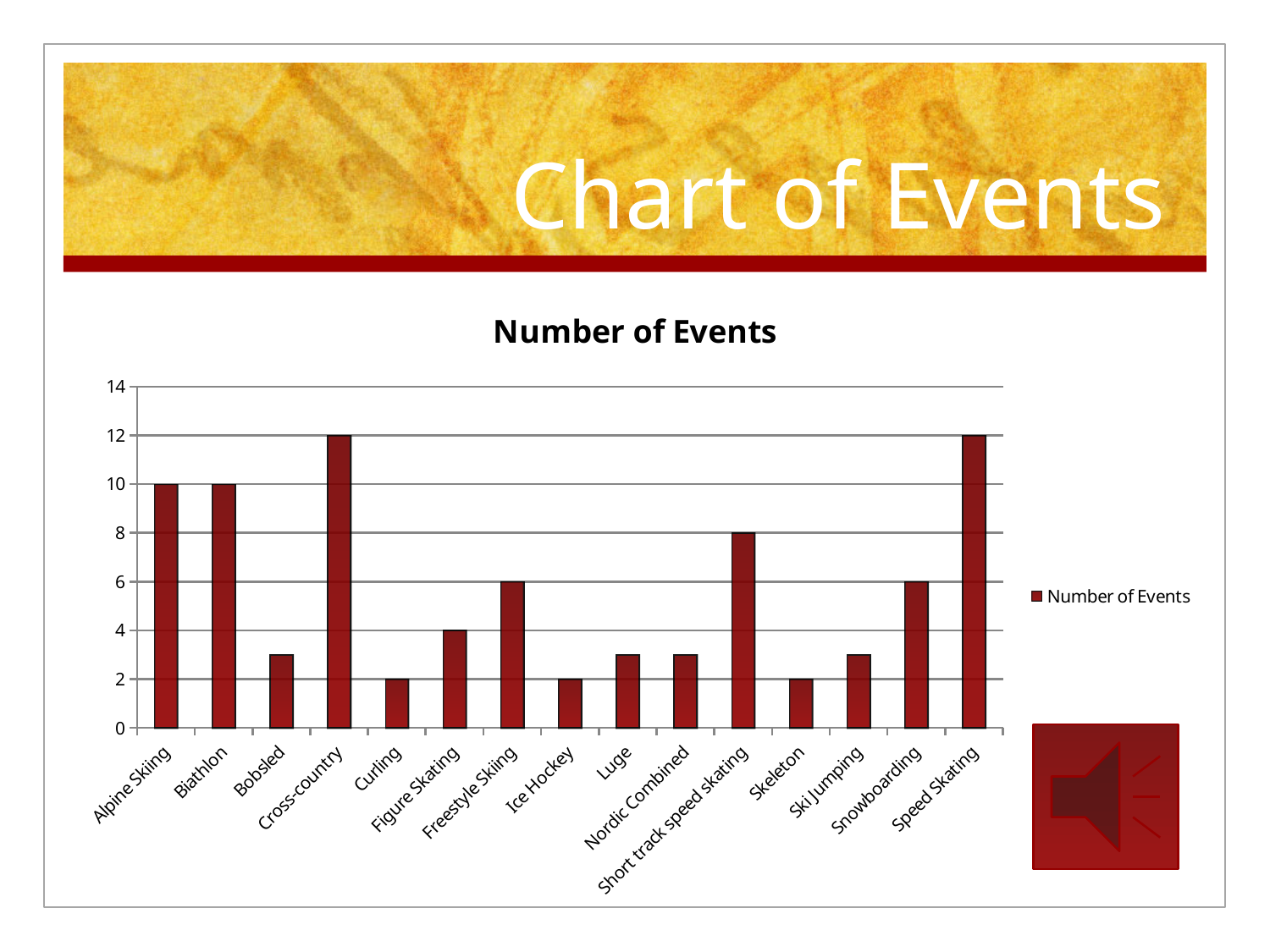
Is the value for Bobsled greater or less than 2? greater What is the value for Short track speed skating? 8 How many categories are shown on the x axis of the chart? 15 What is the value for Cross-country in the Number of Events chart? 12 Which is larger, the value for Cross-country or the value for Short track speed skating? Cross-country What is the value for Figure Skating? 4 What kind of chart is shown on the slide? bar chart What is the value for Alpine Skiing? 10 Is the value for Luge greater or less than 4? less What is the value for Snowboarding? 6 How many series does the legend list? 1 What is the difference between the values for Speed Skating and Freestyle Skiing? 6